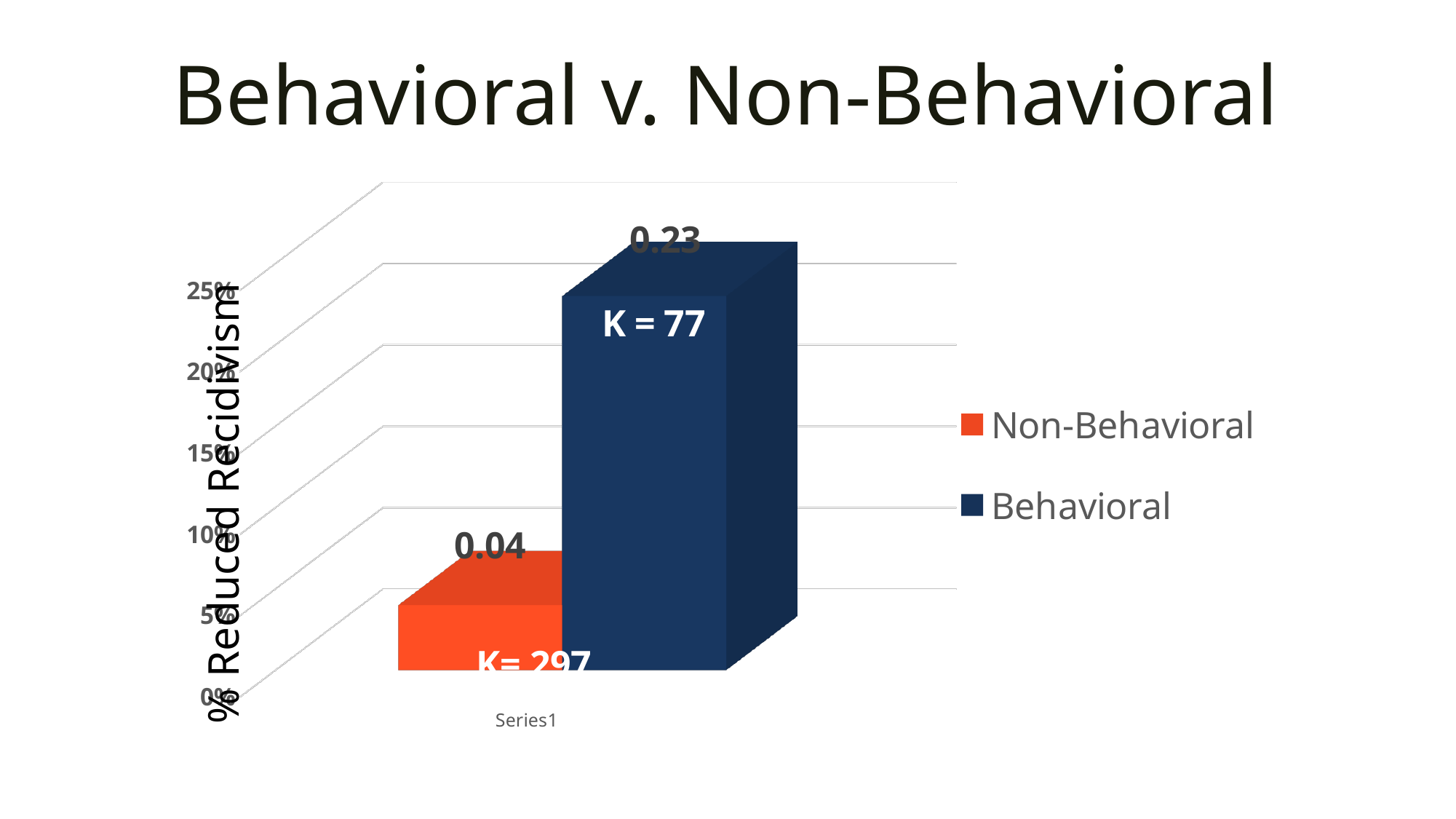
Which series has the lowest value in the chart? Non-Behavioral What K value is printed on the Non-Behavioral bar? K = 297 What is the difference between the Behavioral value and the Non-Behavioral value? 0.19 What kind of chart is shown on the slide? bar chart What is the title of the slide? Behavioral v. Non-Behavioral How many series does the legend list? 2 Which series has the higher value, Behavioral or Non-Behavioral? Behavioral What K value is printed on the Behavioral bar? K = 77 What is the value shown for the Non-Behavioral bar? 0.04 What colour is the Behavioral bar? dark blue Is the value for Non-Behavioral larger or smaller than the value for Behavioral? smaller What is the value shown for the Behavioral bar? 0.23